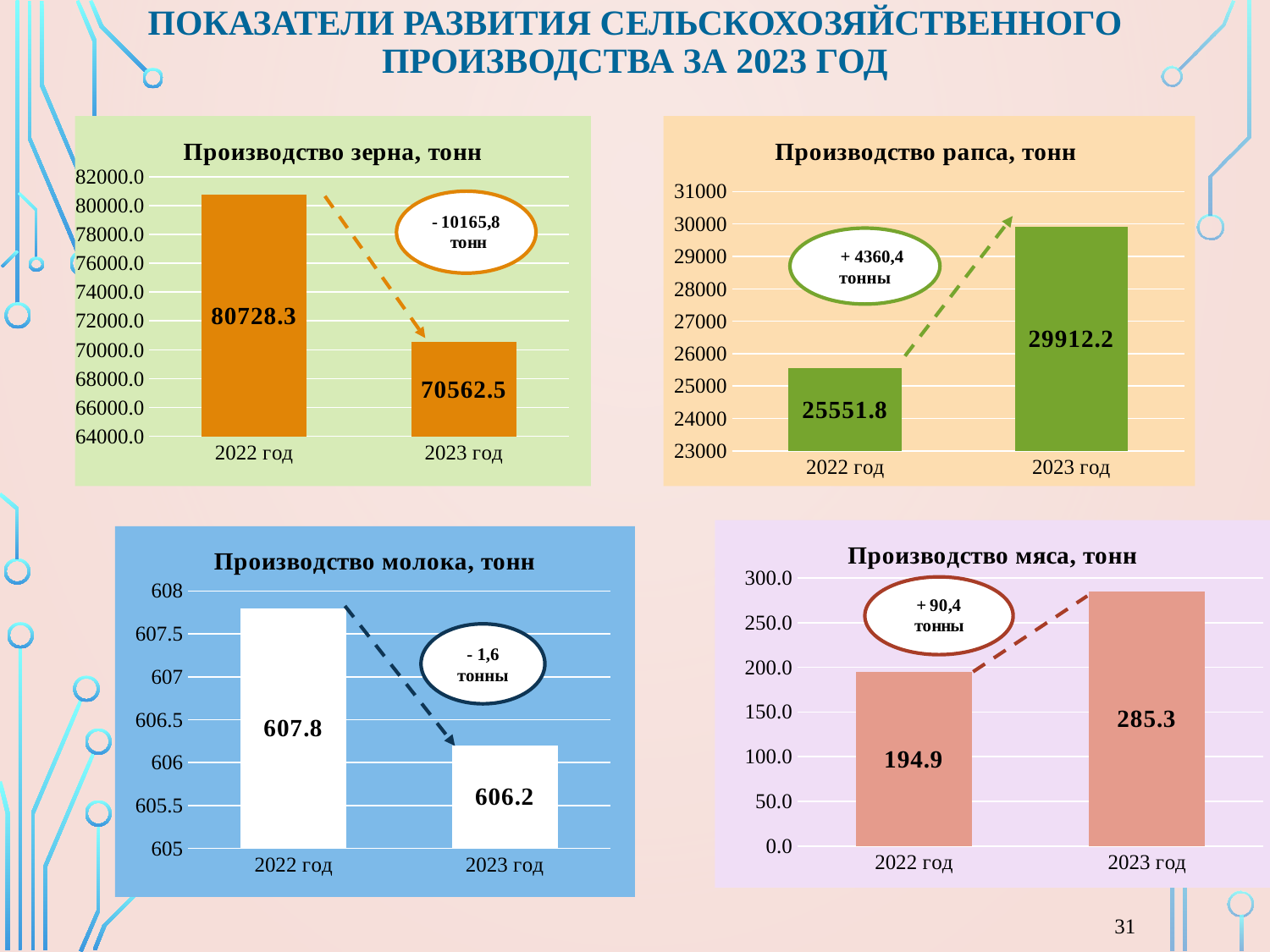
In the chart titled "Производство мяса, тонн", what is the value for 2023 год? 285.3 In the chart titled "Производство зерна, тонн", what is the value for 2022 год? 80728.3 In the chart titled "Производство рапса, тонн", by how much does the 2023 год value exceed the 2022 год value? 4360.4 In the chart titled "Производство мяса, тонн", is the value for 2022 год greater or less than 200.0? less In the chart titled "Производство рапса, тонн", which year has the higher value? 2023 год In the chart titled "Производство зерна, тонн", what is the value for 2023 год? 70562.5 In the chart titled "Производство зерна, тонн", what is the difference between the 2022 год and 2023 год values? 10165.8 In the chart titled "Производство мяса, тонн", what is the difference between the 2023 год and 2022 год values? 90.4 In the chart titled "Производство молока, тонн", do the values rise or fall from 2022 год to 2023 год? fall What type of chart is the chart titled "Производство молока, тонн"? bar chart In the chart titled "Производство рапса, тонн", what is the value for 2023 год? 29912.2 In the chart titled "Производство молока, тонн", what is the value for 2022 год? 607.8